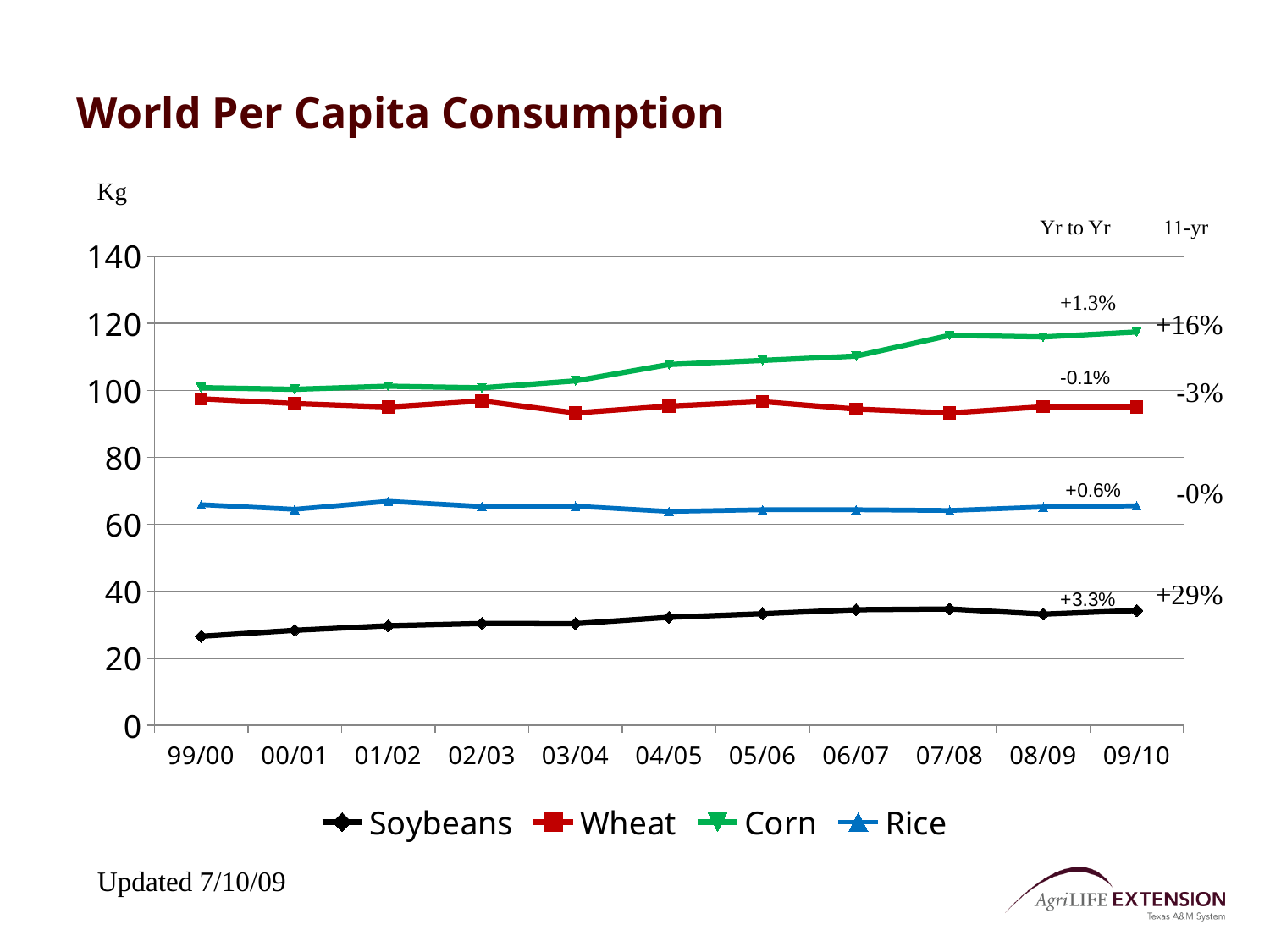
Is the value for Soybeans in 99/00 greater or less than 40? less How many series does the legend list? 4 What kind of chart is shown on the slide? line chart Does the Corn line rise or fall from 99/00 to 09/10? rise What is the Yr to Yr change shown for Corn? +1.3% What is the 11-yr change shown for Soybeans? +29% Which series has the lowest value in 09/10? Soybeans Is the value for Corn in 09/10 greater or less than 100? greater Is the value for Rice in 04/05 greater or less than 80? less Which series has the highest value in 09/10? Corn How many marketing years are plotted along the x axis? 11 In 09/10, which is larger, the value for Corn or the value for Wheat? Corn